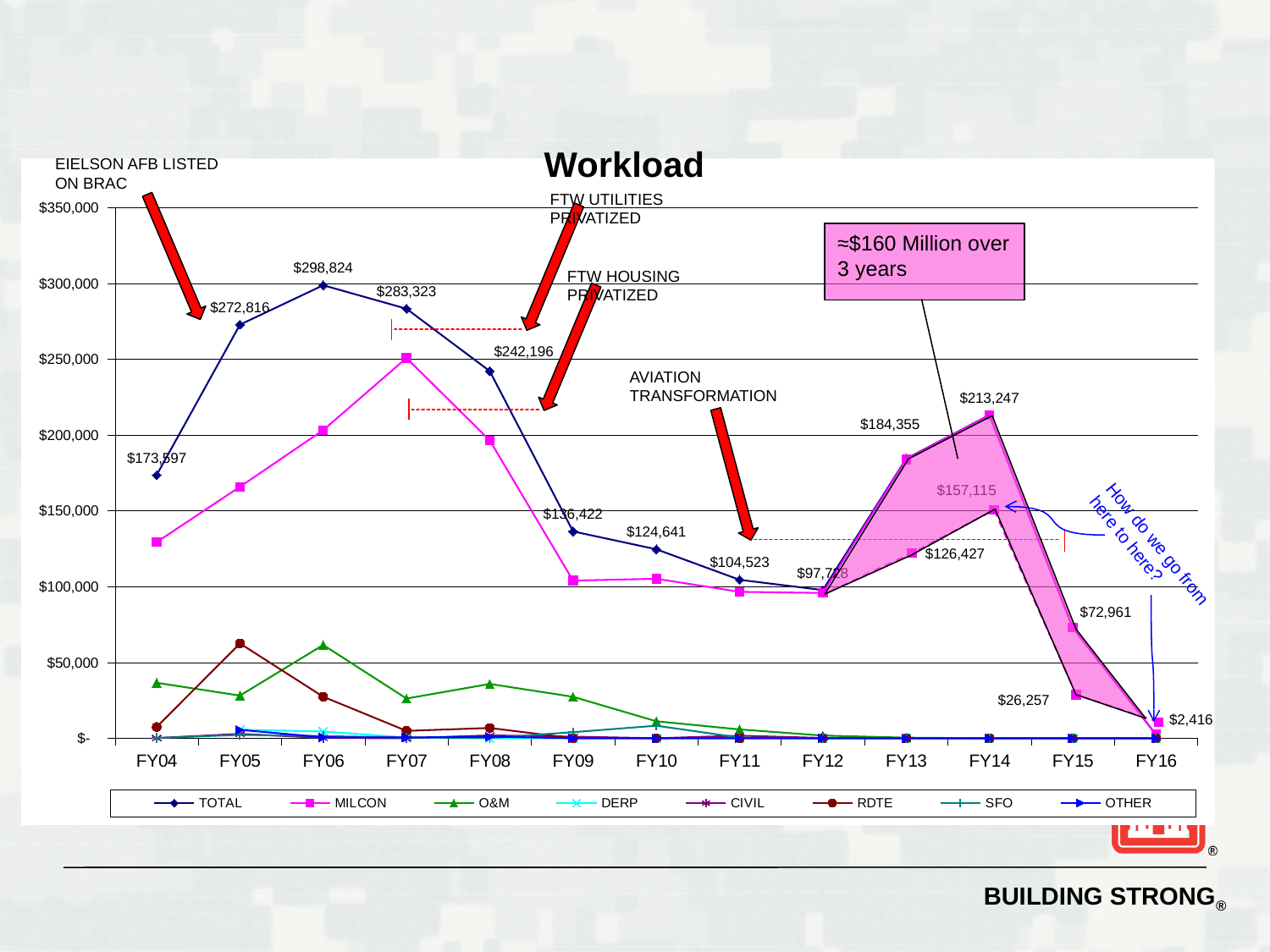
In which fiscal year is the TOTAL series highest? FY06 Which is larger, the TOTAL value for FY07 or for FY08? FY07 How many series does the legend list? 8 Is the MILCON value for FY04 greater or less than $100,000? greater What kind of chart is shown on the slide? line chart In which fiscal year is the TOTAL series lowest? FY16 How many fiscal years are shown on the x axis? 13 Does the TOTAL series rise or fall from FY06 to FY12? fall What is the TOTAL value for FY06? $298,824 What is the difference between the TOTAL values for FY14 and FY13? $28,892 What is the TOTAL value for FY13? $184,355